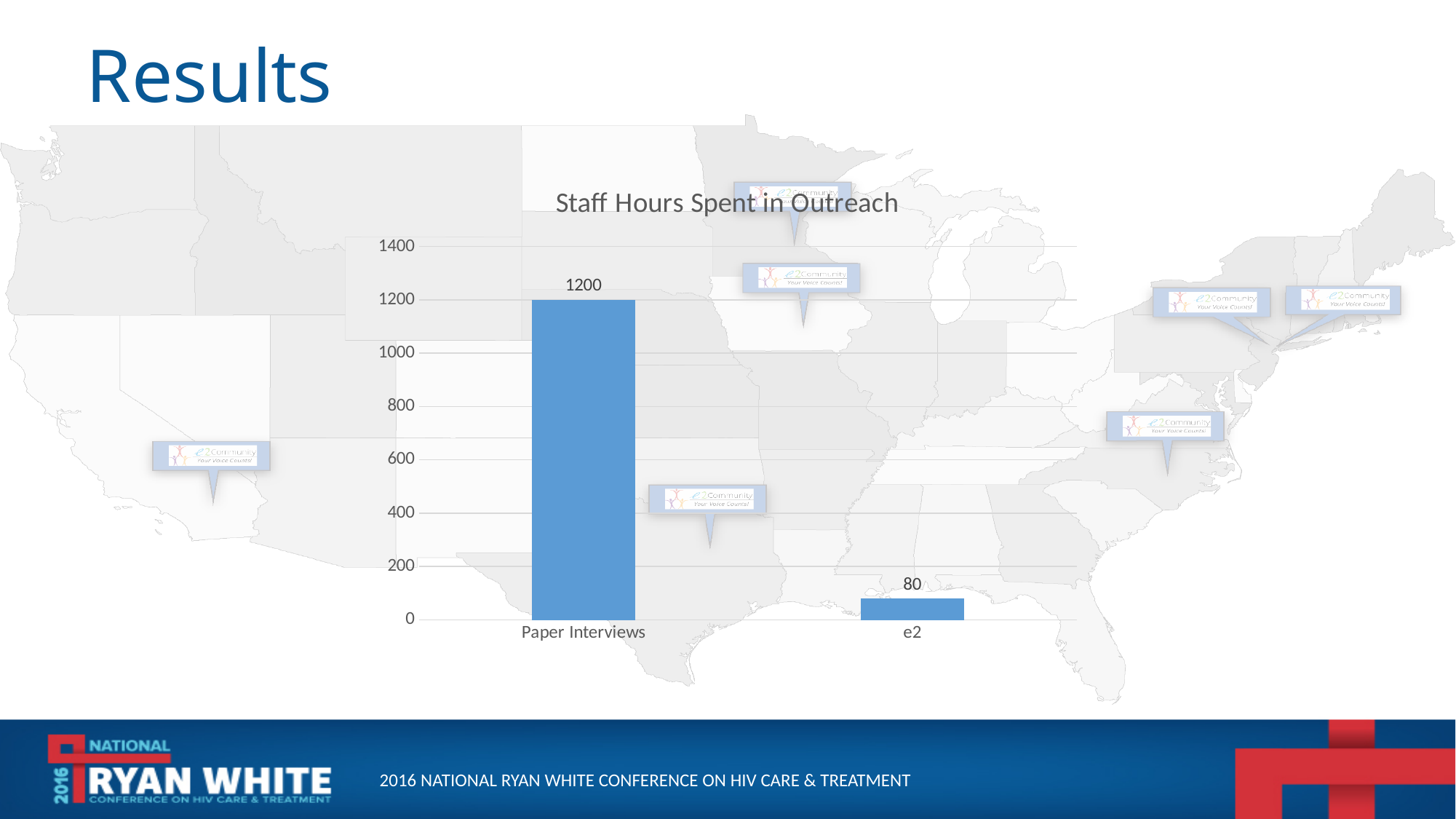
What is the highest value shown on the vertical axis of the Staff Hours Spent in Outreach chart? 1400 Is the value for Paper Interviews greater or less than 1000 in the Staff Hours Spent in Outreach chart? greater Which category has the lowest value in the Staff Hours Spent in Outreach chart? e2 What is the difference between the Paper Interviews and e2 values in the Staff Hours Spent in Outreach chart? 1120 What is the title of the chart on the slide? Staff Hours Spent in Outreach How many categories are shown in the Staff Hours Spent in Outreach chart? 2 Is the value for e2 greater or less than 200 in the Staff Hours Spent in Outreach chart? less What kind of chart is the Staff Hours Spent in Outreach chart? bar chart Which is larger in the Staff Hours Spent in Outreach chart, Paper Interviews or e2? Paper Interviews What is the value for e2 in the Staff Hours Spent in Outreach chart? 80 Which category has the highest value in the Staff Hours Spent in Outreach chart? Paper Interviews What is the value for Paper Interviews in the Staff Hours Spent in Outreach chart? 1200